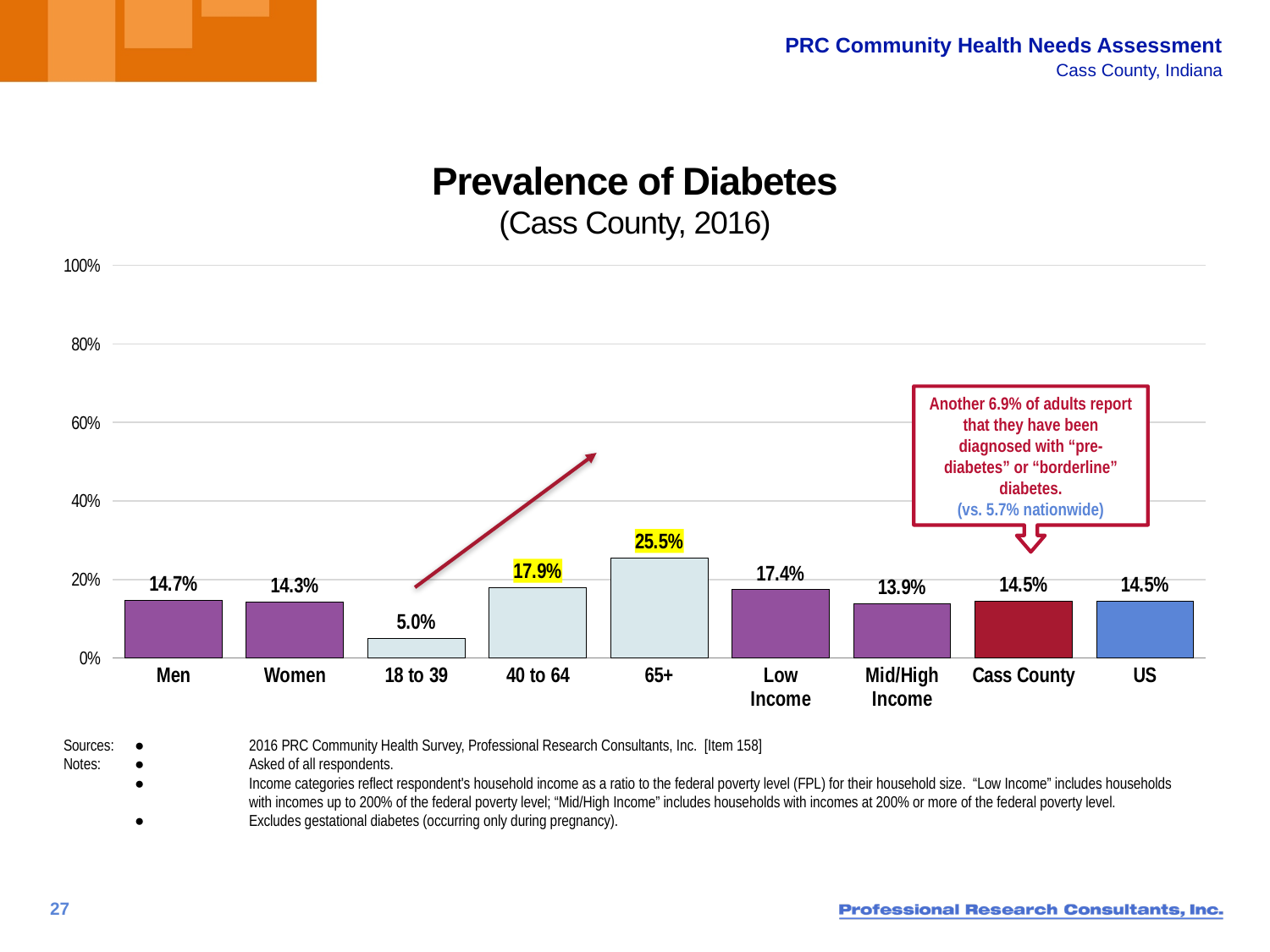
How many categories are shown on the x axis? 9 What is the prevalence of diabetes for Men? 14.7% Is the value for 65+ greater or less than 20%? greater What is the value for Low Income? 17.4% What is the difference between the values for 65+ and 18 to 39? 20.5% Which is larger, the value for Men or the value for Women? Men What is the difference between the values for Low Income and Mid/High Income? 3.5% Which category has the lowest prevalence of diabetes? 18 to 39 Which category has the highest prevalence of diabetes? 65+ What kind of chart is shown on the slide? bar chart What is the prevalence of diabetes for the 65+ age group? 25.5% Do the values rise or fall across the age groups from 18 to 39 to 65+? rise